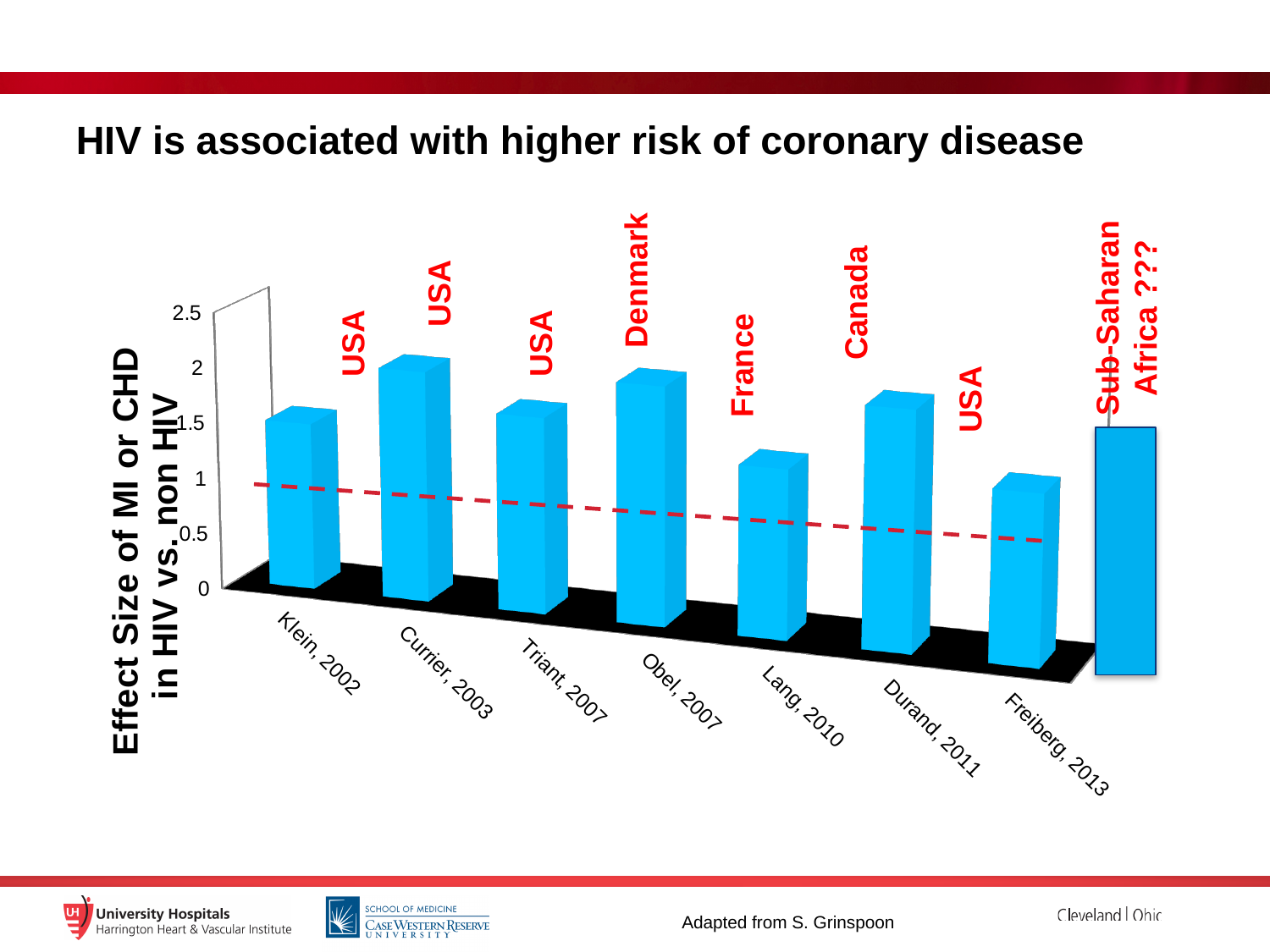
Is the value for Currier, 2003 greater or less than 1? greater Which study is listed first on the x axis of the chart? Klein, 2002 Which is larger, the value for Obel, 2007 or the value for Freiberg, 2013? Obel, 2007 Is the value for Durand, 2011 greater or less than 1? greater Which is larger, the value for Currier, 2003 or the value for Lang, 2010? Currier, 2003 What is the highest value shown on the y axis of the chart? 2.5 What is the y-axis title of the chart? Effect Size of MI or CHD in HIV vs. non HIV Is the value for Obel, 2007 greater or less than 1? greater What kind of chart is shown on the slide? bar chart How many studies (categories) are plotted along the x axis of the chart? 7 Which is larger, the value for Currier, 2003 or the value for Freiberg, 2013? Currier, 2003